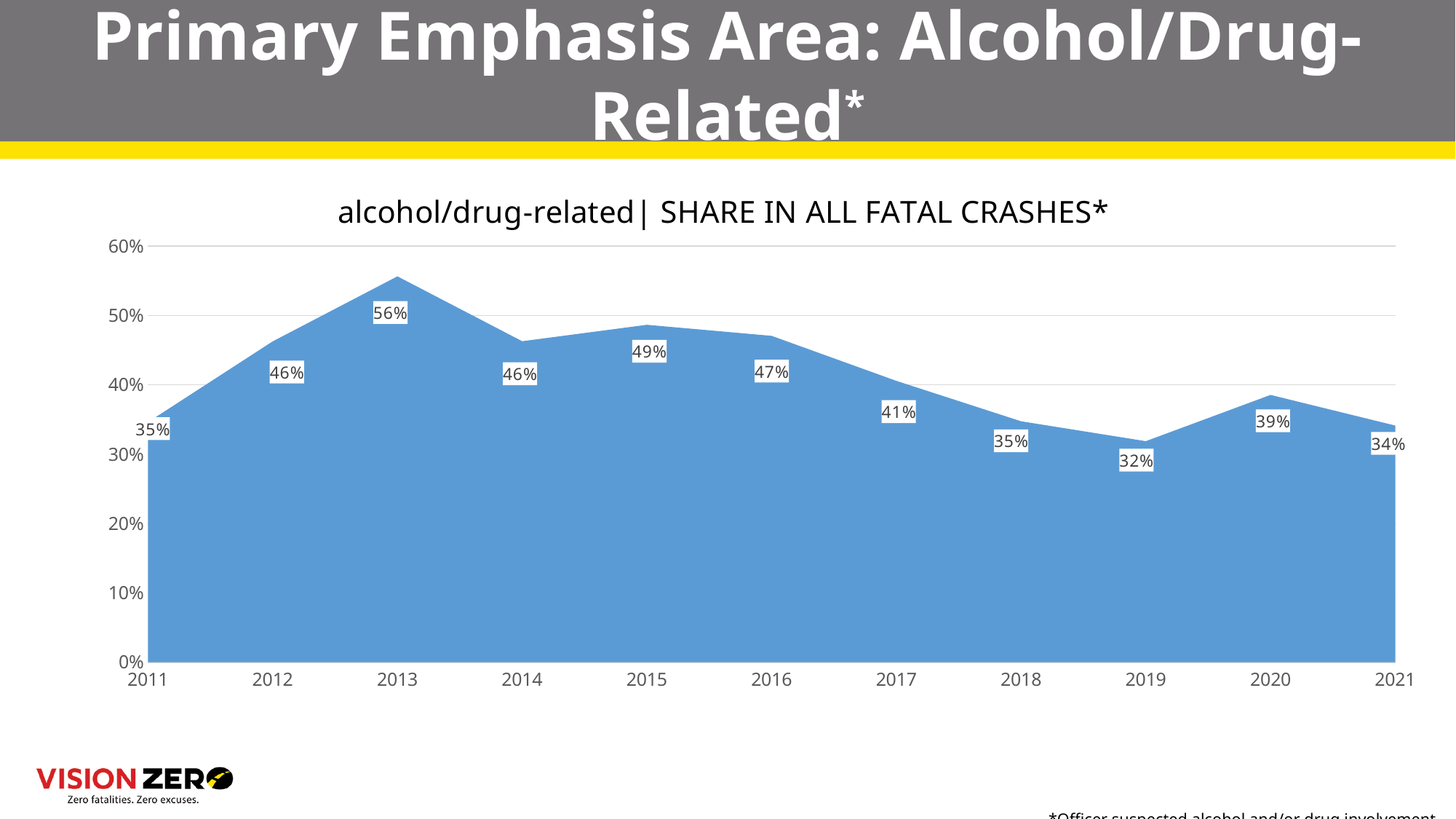
What is the title of the chart? alcohol/drug-related| SHARE IN ALL FATAL CRASHES* How many years are plotted on the x axis? 11 What is the difference between the 2013 and 2019 shares? 24% Does the share rise or fall from 2016 to 2019? Fall What is the alcohol/drug-related share in all fatal crashes for 2019? 32% What is the alcohol/drug-related share in all fatal crashes for 2013? 56% What kind of chart is shown on the slide? Area chart What is the alcohol/drug-related share in all fatal crashes for 2016? 47% Which year has the highest alcohol/drug-related share in all fatal crashes? 2013 What colour is the area in the chart? Blue Which year has a larger share, 2015 or 2020? 2015 Which year has the lowest alcohol/drug-related share in all fatal crashes? 2019